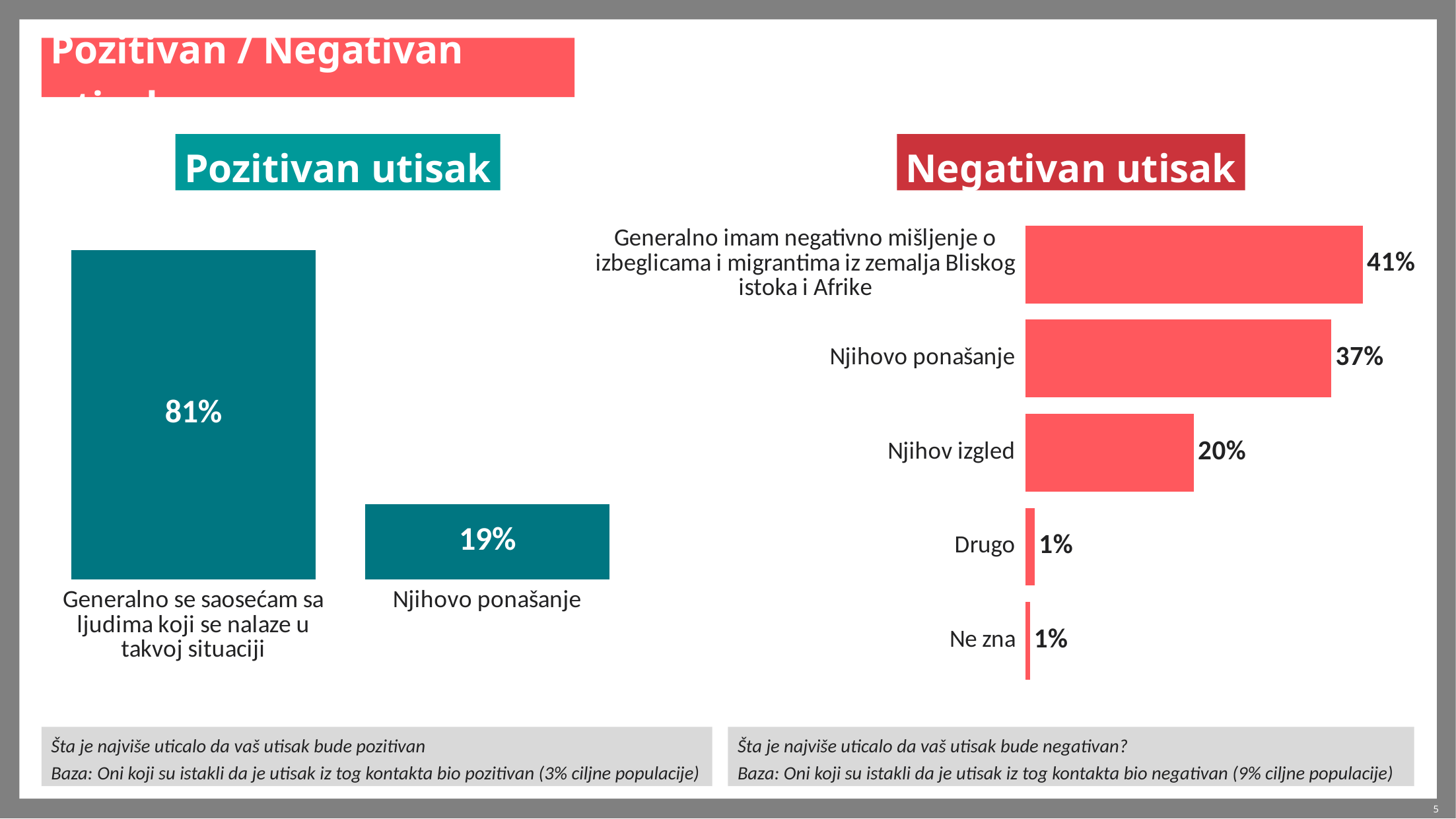
In the 'Pozitivan utisak' chart, what is the value for 'Njihovo ponašanje'? 19% In the 'Pozitivan utisak' chart, how many categories are shown? 2 In the 'Negativan utisak' chart, how many categories are shown? 5 In the 'Negativan utisak' chart, which is larger: 'Njihovo ponašanje' or 'Njihov izgled'? Njihovo ponašanje In the 'Negativan utisak' chart, what is the difference between 'Njihovo ponašanje' and 'Njihov izgled'? 17% In the 'Negativan utisak' chart, what is the value for 'Njihovo ponašanje'? 37% What kind of chart is the 'Negativan utisak' chart? Bar chart In the 'Negativan utisak' chart, what is the value for 'Njihov izgled'? 20% In the 'Pozitivan utisak' chart, what is the difference between the two bars? 62% In the 'Negativan utisak' chart, what is the value for 'Ne zna'? 1% In the 'Negativan utisak' chart, which category has the highest value? Generalno imam negativno mišljenje o izbeglicama i migrantima iz zemalja Bliskog istoka i Afrike In the 'Pozitivan utisak' chart, what is the value for 'Generalno se saosećam sa ljudima koji se nalaze u takvoj situaciji'? 81%